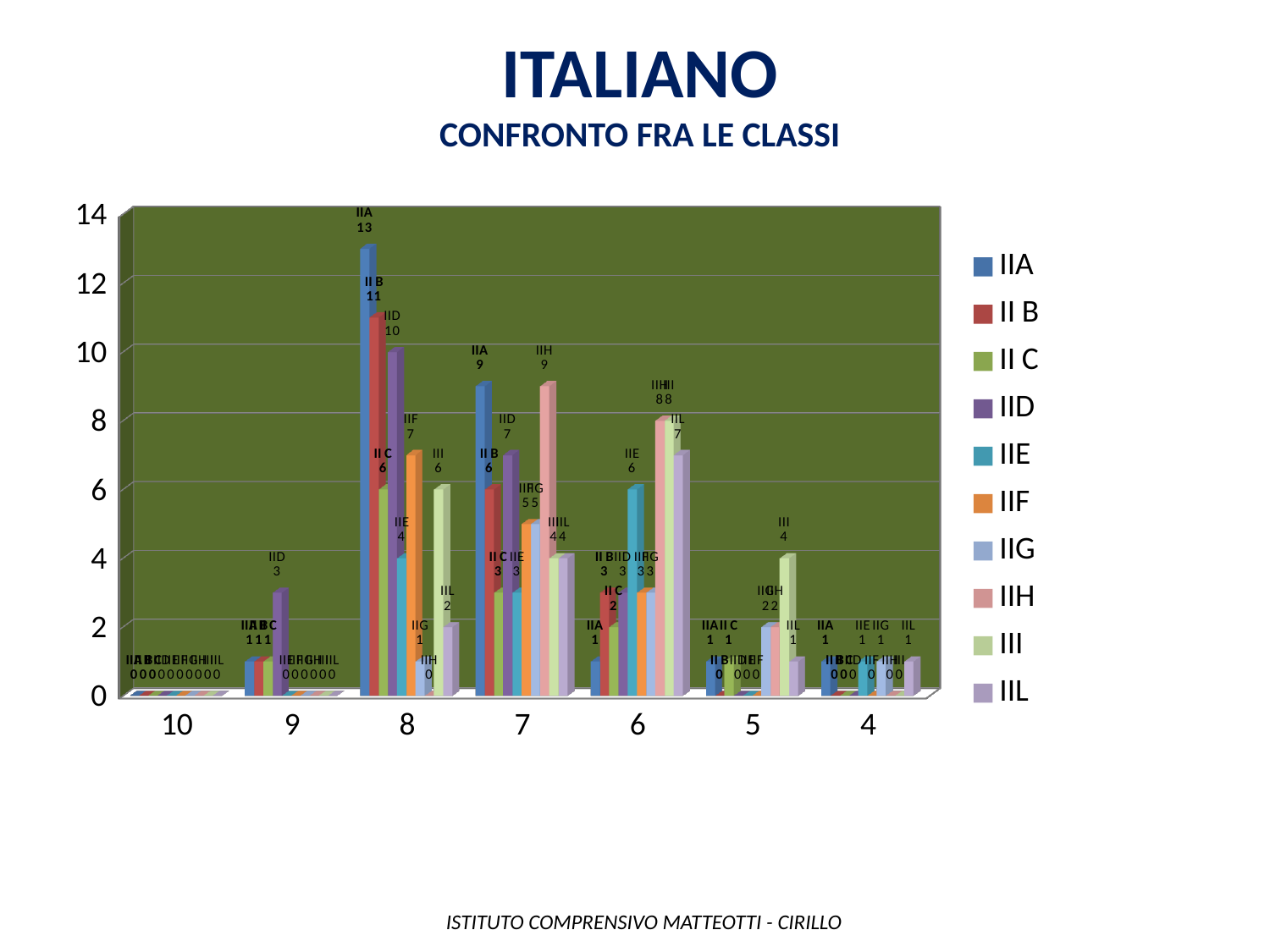
What is the value for II B at grade 8? 11 What is the title of the chart? ITALIANO CONFRONTO FRA LE CLASSI Which series has the highest value at grade 5? III Which series has the highest value at grade 8? IIA What kind of chart is shown on the slide? bar chart What is the value for IIH at grade 7? 9 What is the value for IID at grade 9? 3 Which is larger at grade 6: IIH or IIE? IIH How many grade categories are shown on the x axis? 7 What is the difference between IIA and II B at grade 8? 2 How many series does the legend list? 10 What is the value for IIA at grade 8? 13